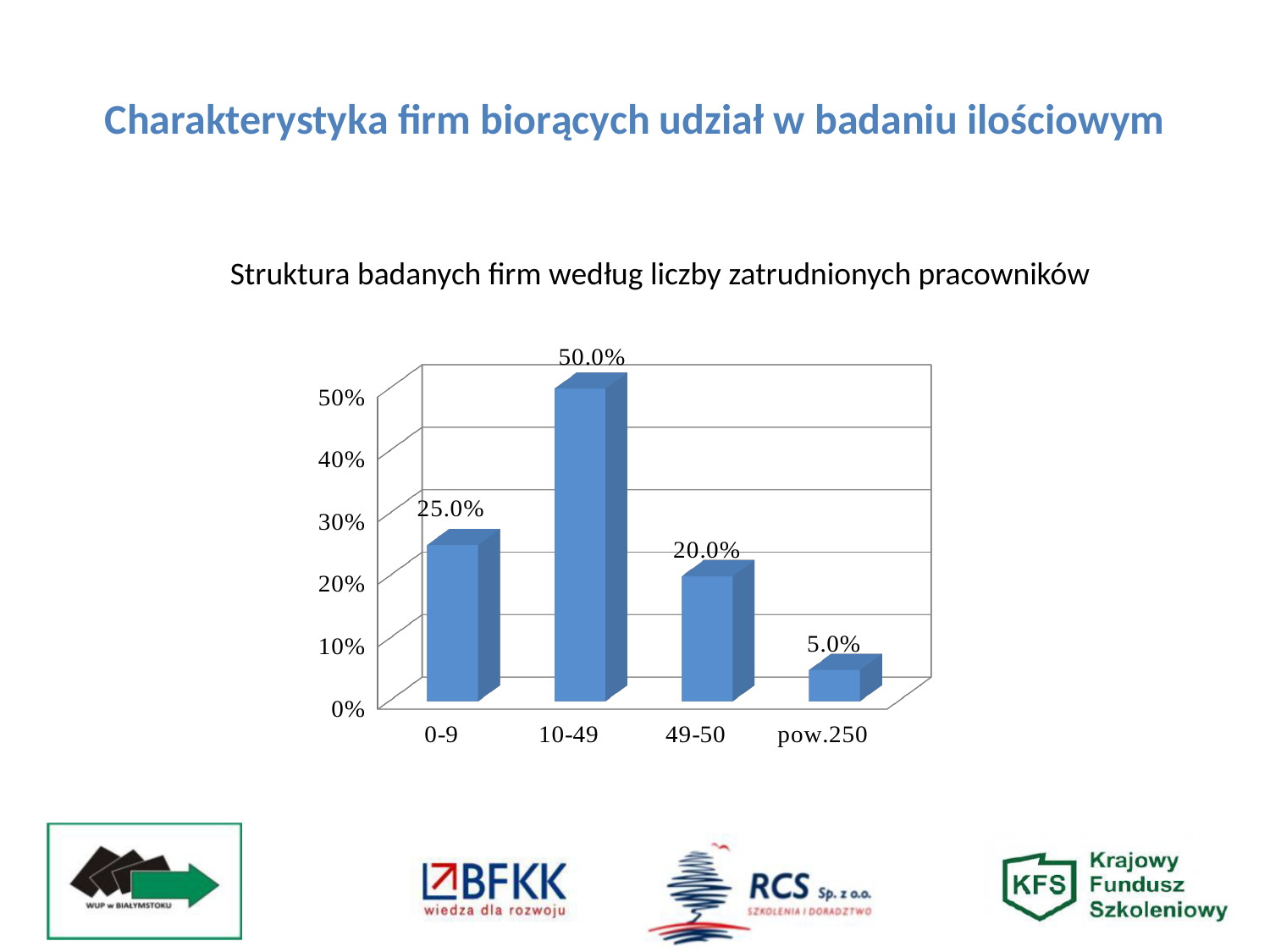
What is the difference between the values for 10-49 and 0-9? 25.0% What is the value for the 49-50 category? 20.0% Which category has the highest value? 10-49 Which category has the lowest value? pow.250 What is the value for the 10-49 category? 50.0% What is the difference between the values for 49-50 and pow.250? 15.0% Which is larger, the value for 0-9 or the value for 49-50? 0-9 What is the value for the 0-9 category? 25.0% What is the title of the chart? Struktura badanych firm według liczby zatrudnionych pracowników What kind of chart is shown on the slide? bar chart How many categories are shown on the x axis? 4 What is the value for the pow.250 category? 5.0%